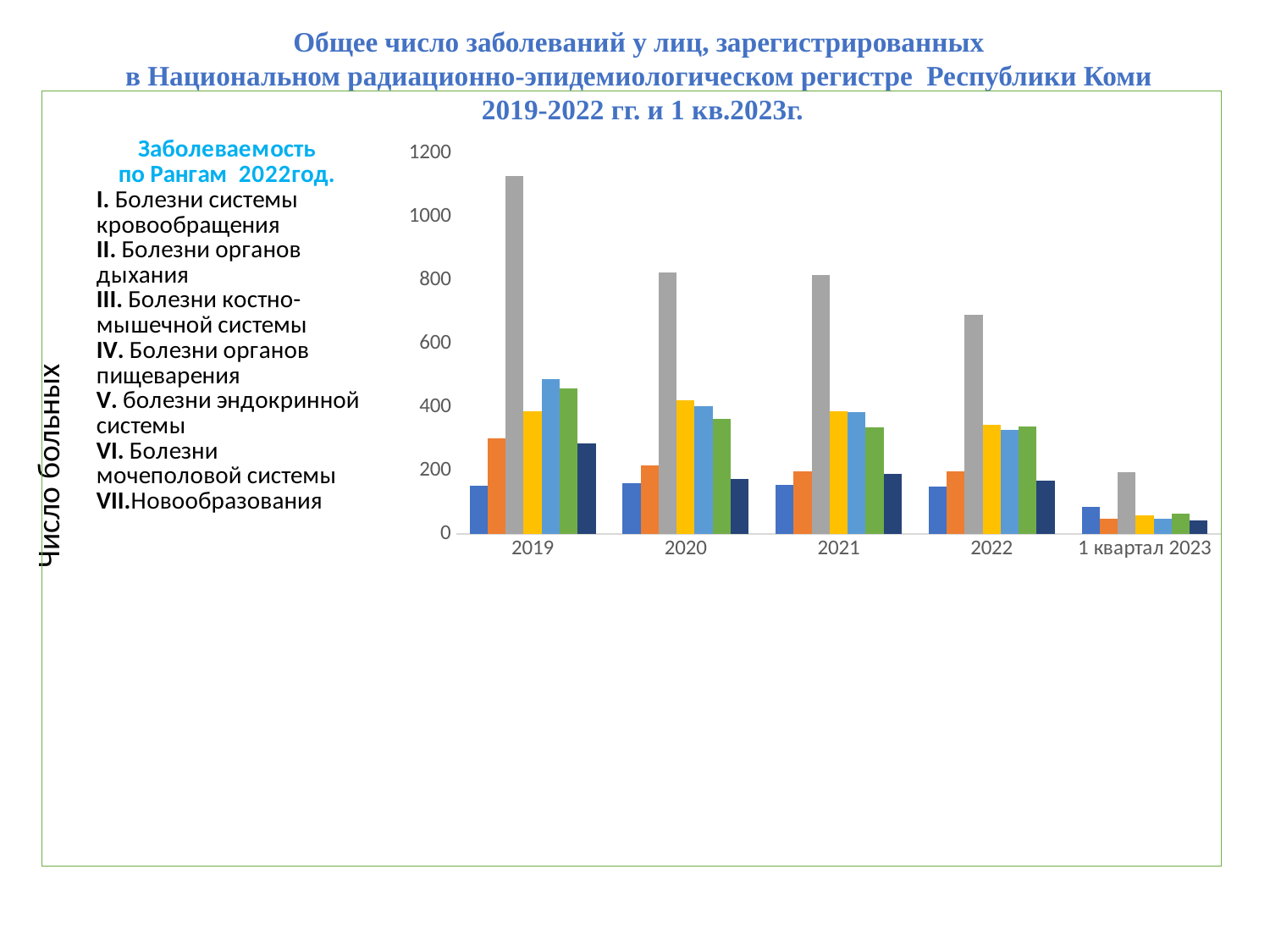
What is the label on the vertical axis of the chart? Число больных In which category is the gray bar the tallest? 2019 Which is larger for 2019: the gray bar or the orange bar? the gray bar Is the value of the light blue bar for 2019 greater or less than 400? greater Is the value of the gray bar for 2022 greater or less than 800? less Is the value of the gray bar for 2019 greater or less than 1000? greater What kind of chart is shown on the slide? bar chart How many categories are shown along the x axis of the chart? 5 Do the gray bars rise or fall from 2019 to 1 квартал 2023? fall In which category are the bars lowest overall? 1 квартал 2023 How many bars are plotted for each category on the chart? 7